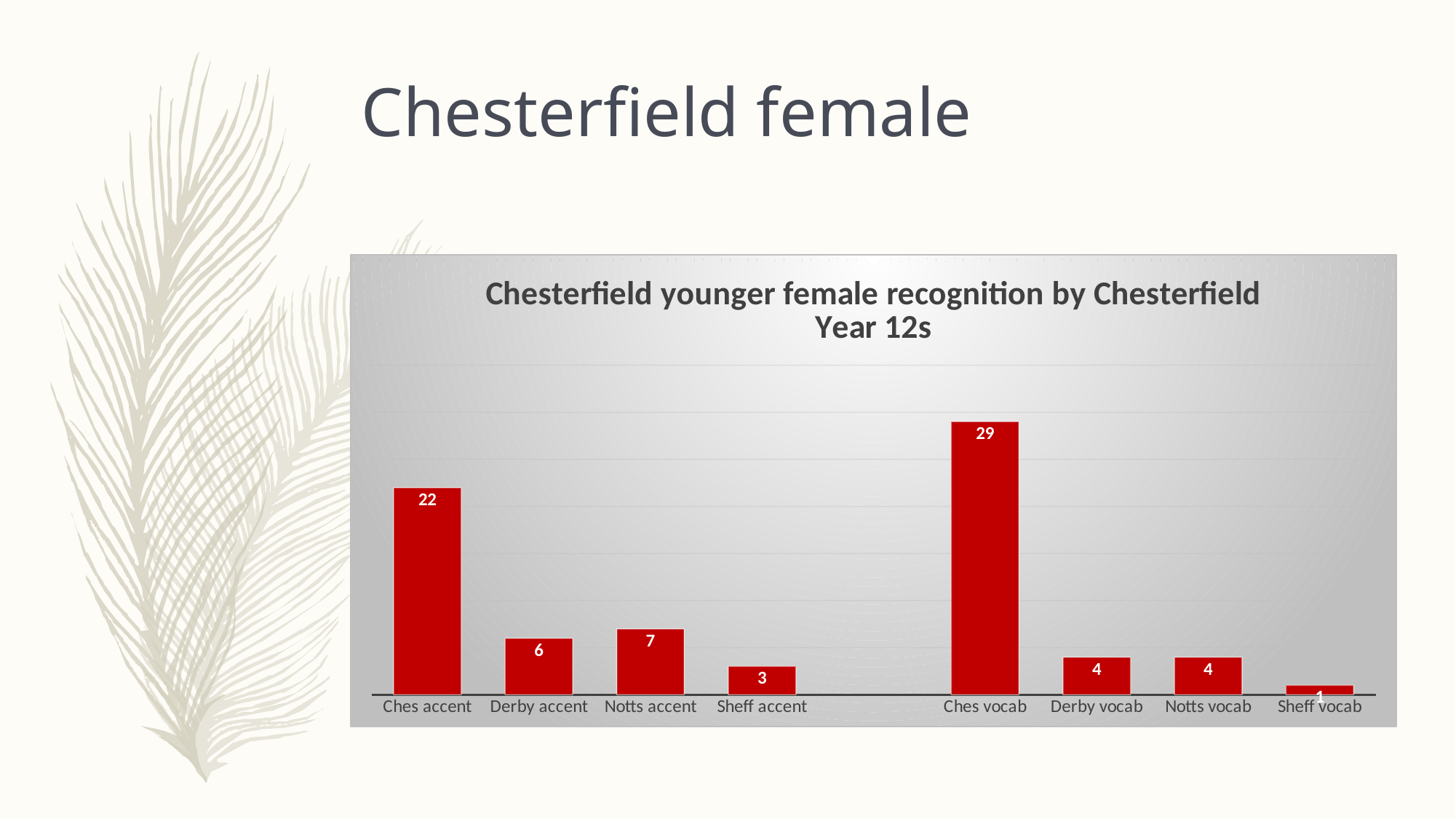
What is the value for Notts accent? 7 What is the difference between the values for Derby accent and Sheff accent? 3 What kind of chart is shown on the slide? Bar chart What is the value for Ches accent? 22 What is the value for Sheff vocab? 1 What is the value for Ches vocab? 29 What is the difference between the values for Ches vocab and Ches accent? 7 Which category has the lowest value? Sheff vocab Which category has the highest value? Ches vocab Which is larger, the value for Derby accent or the value for Notts accent? Notts accent How many categories are shown on the x axis? 8 What is the title of the chart? Chesterfield younger female recognition by Chesterfield Year 12s